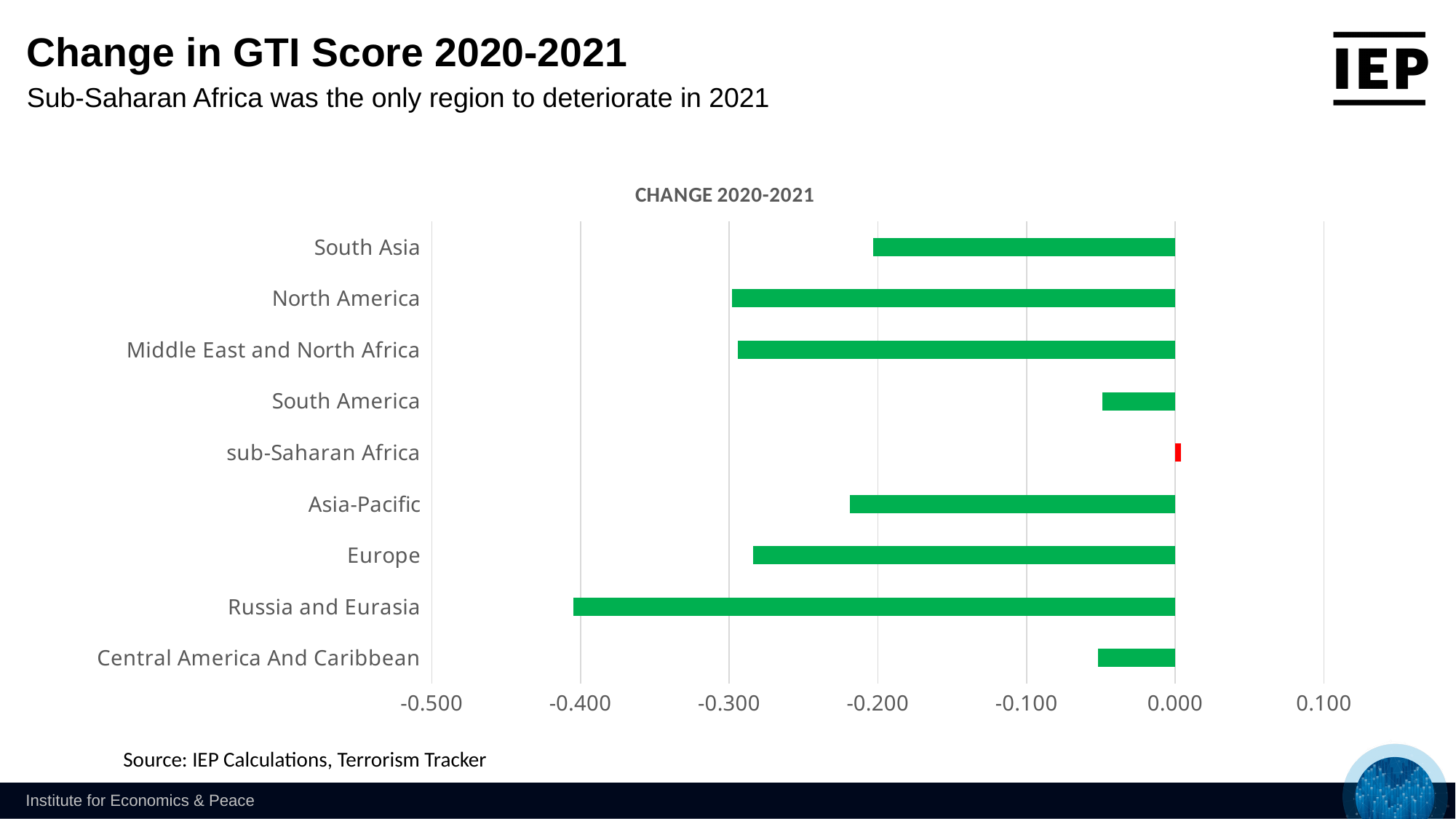
Which region shows a larger decrease in GTI score, Europe or South Asia? Europe Is the value for South America greater or less than -0.100? greater Is the value for North America greater or less than -0.200? less What kind of chart is shown on the slide? bar chart Is the value for Europe greater or less than -0.200? less What is the title printed above the chart? CHANGE 2020-2021 Which region shows a larger decrease in GTI score, Russia and Eurasia or Europe? Russia and Eurasia Which region is the only one with a positive change in GTI score? sub-Saharan Africa Which region has the largest decrease (most negative change) in GTI score? Russia and Eurasia How many regions are plotted in the chart? 9